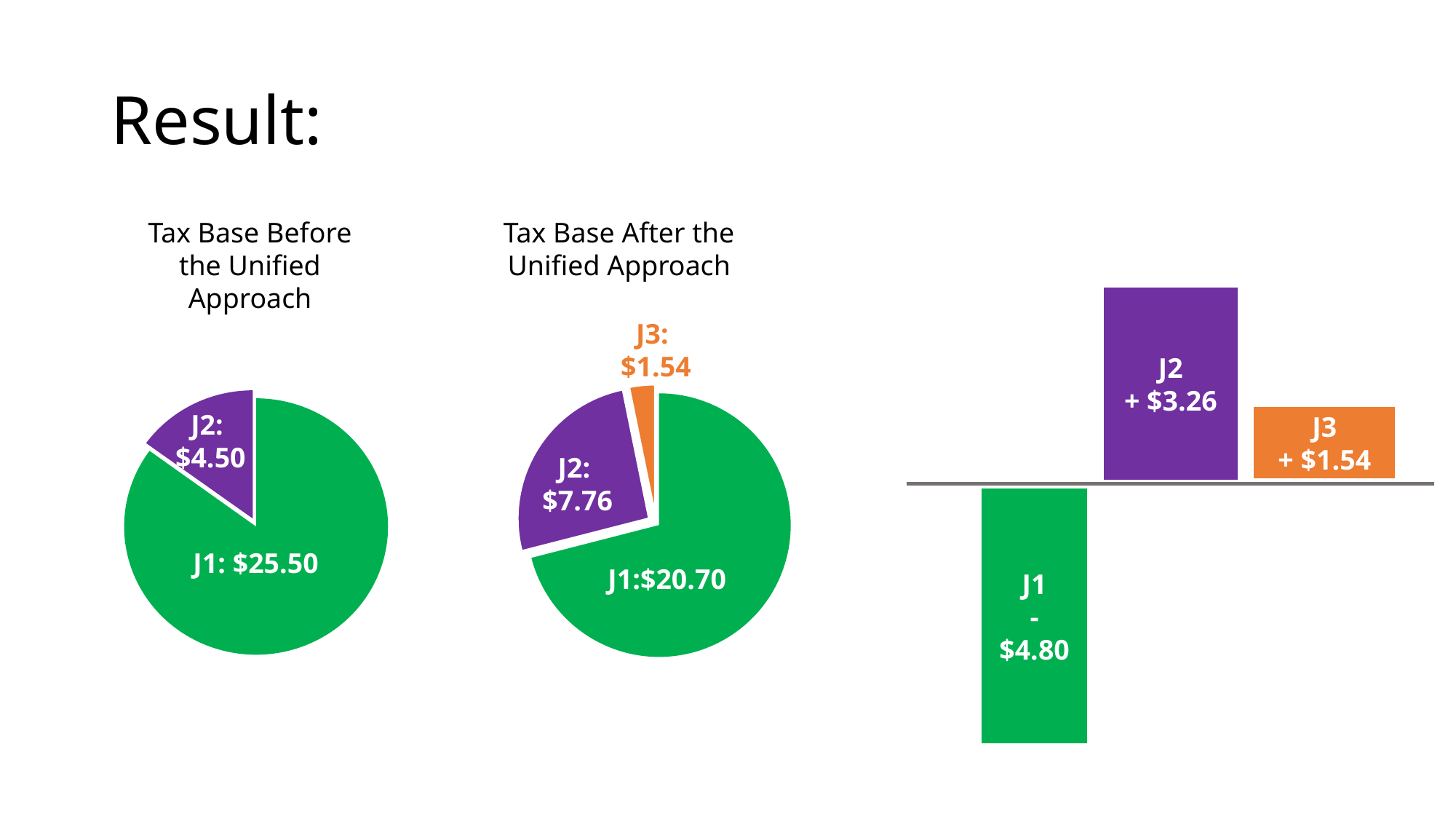
What kind of chart is the chart on the right of the slide? Bar chart In the 'Tax Base Before the Unified Approach' pie chart, what is the value for J2? $4.50 How many slices does the 'Tax Base Before the Unified Approach' pie chart have? 2 In the bar chart on the right of the slide, which is larger, the value for J2 or the value for J3? J2 In the bar chart on the right of the slide, what is the value shown for J1? - $4.80 In the 'Tax Base Before the Unified Approach' pie chart, what share of the total does J2 represent? 15% What is the difference between J1's value in the 'Tax Base Before the Unified Approach' pie chart and J1's value in the 'Tax Base After the Unified Approach' pie chart? $4.80 In the 'Tax Base After the Unified Approach' pie chart, what is the value for J1? $20.70 In the bar chart on the right of the slide, what is the value shown for J2? + $3.26 How many slices does the 'Tax Base After the Unified Approach' pie chart have? 3 In the 'Tax Base After the Unified Approach' pie chart, which slice is the smallest? J3 In the 'Tax Base After the Unified Approach' pie chart, which slice is the largest? J1